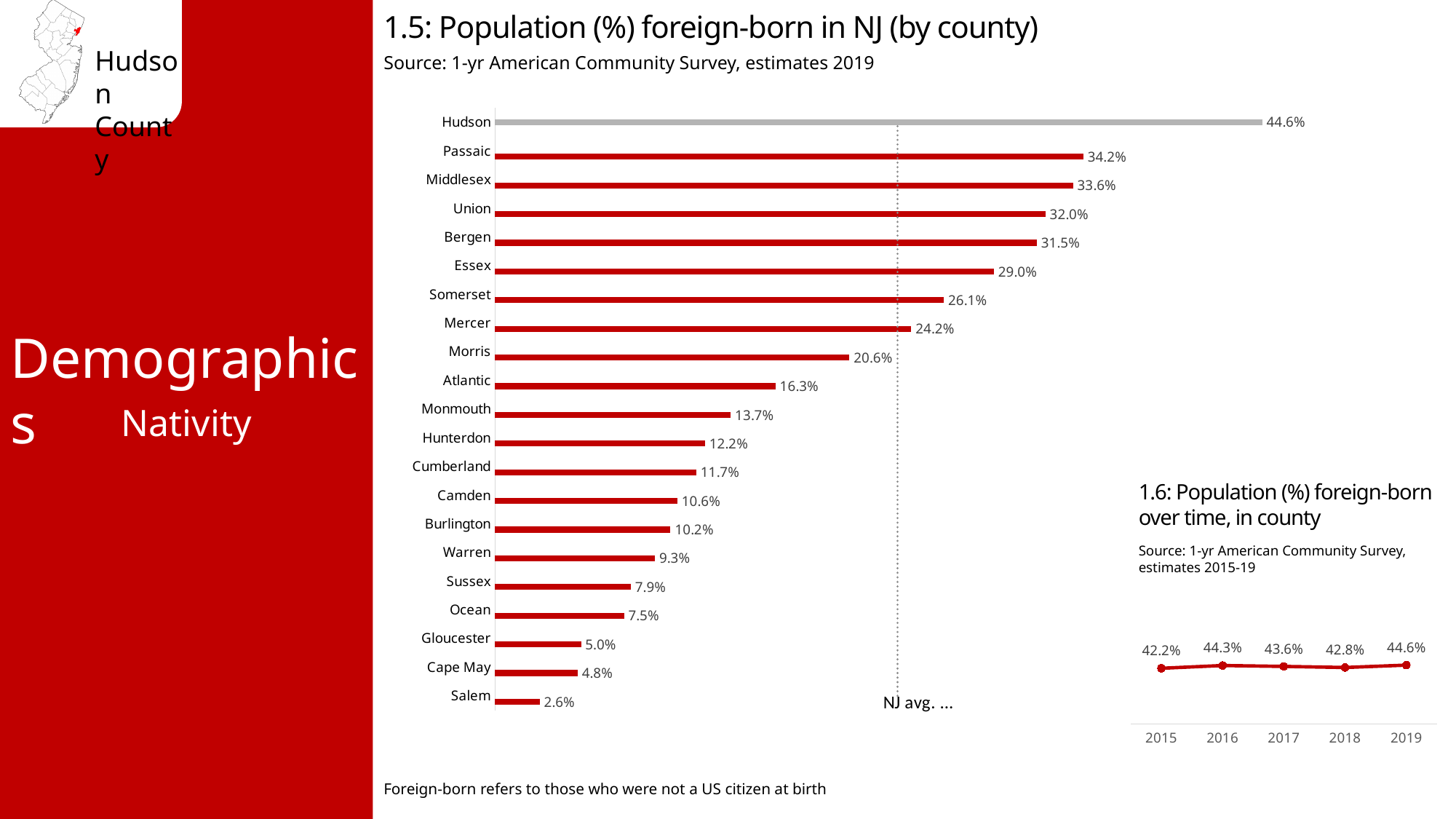
What kind of chart is chart 1.5 (Population (%) foreign-born in NJ by county)? Bar chart In chart 1.6 (Population (%) foreign-born over time, in county), what is the difference between 2019 and 2015? 2.4% In chart 1.5 (Population (%) foreign-born in NJ by county), how many counties are plotted? 21 In chart 1.5 (Population (%) foreign-born in NJ by county), which is larger, Camden or Burlington? Camden What kind of chart is chart 1.6 (Population (%) foreign-born over time, in county)? Line chart In chart 1.5 (Population (%) foreign-born in NJ by county), what is the value for Bergen? 31.5% In chart 1.6 (Population (%) foreign-born over time, in county), which year has the lowest value? 2015 In chart 1.5 (Population (%) foreign-born in NJ by county), which county has the highest value? Hudson In chart 1.5 (Population (%) foreign-born in NJ by county), what is the difference between Passaic and Middlesex? 0.6% In chart 1.5 (Population (%) foreign-born in NJ by county), what is the value for Hudson? 44.6% In chart 1.6 (Population (%) foreign-born over time, in county), what is the value for 2017? 43.6% In chart 1.5 (Population (%) foreign-born in NJ by county), which county has the lowest value? Salem